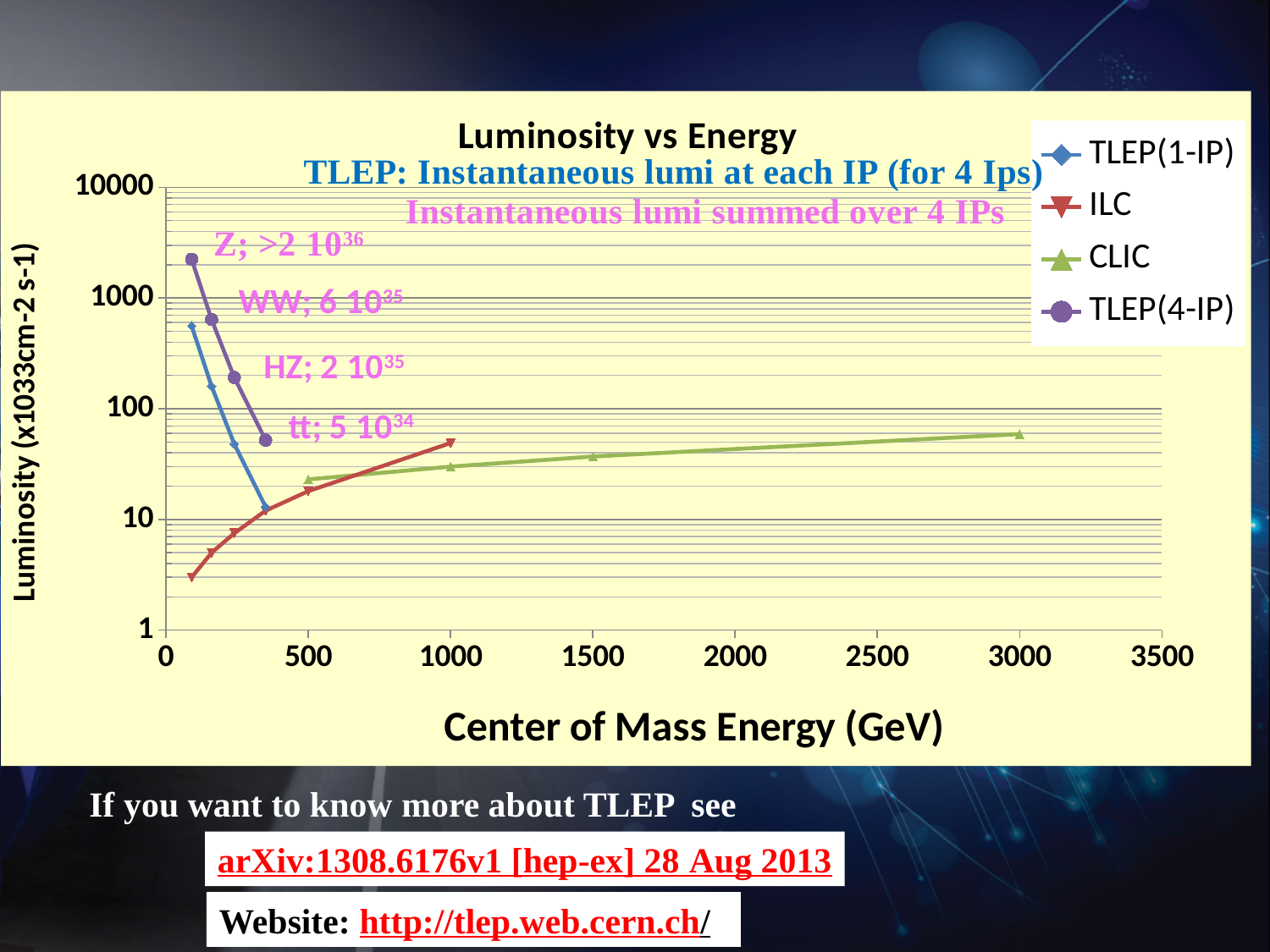
Is the highest luminosity of the TLEP(4-IP) series greater or less than 1000? greater Does the luminosity of the CLIC series rise or fall as the center of mass energy increases? rise Does the luminosity of the TLEP(4-IP) series rise or fall as the center of mass energy increases? fall What is the title of the chart? Luminosity vs Energy At the lowest center of mass energy plotted, which series has the higher luminosity, TLEP(4-IP) or TLEP(1-IP)? TLEP(4-IP) Does the luminosity of the ILC series rise or fall as the center of mass energy increases? rise Which series reaches the highest luminosity on the chart? TLEP(4-IP) How many series does the legend of the Luminosity vs Energy chart list? 4 Is the luminosity of the CLIC series at 3000 GeV greater or less than 100? less Is the luminosity of the ILC series at 1000 GeV greater or less than 10? greater What is the label of the x axis of the chart? Center of Mass Energy (GeV) What type of chart is shown on the slide? line chart